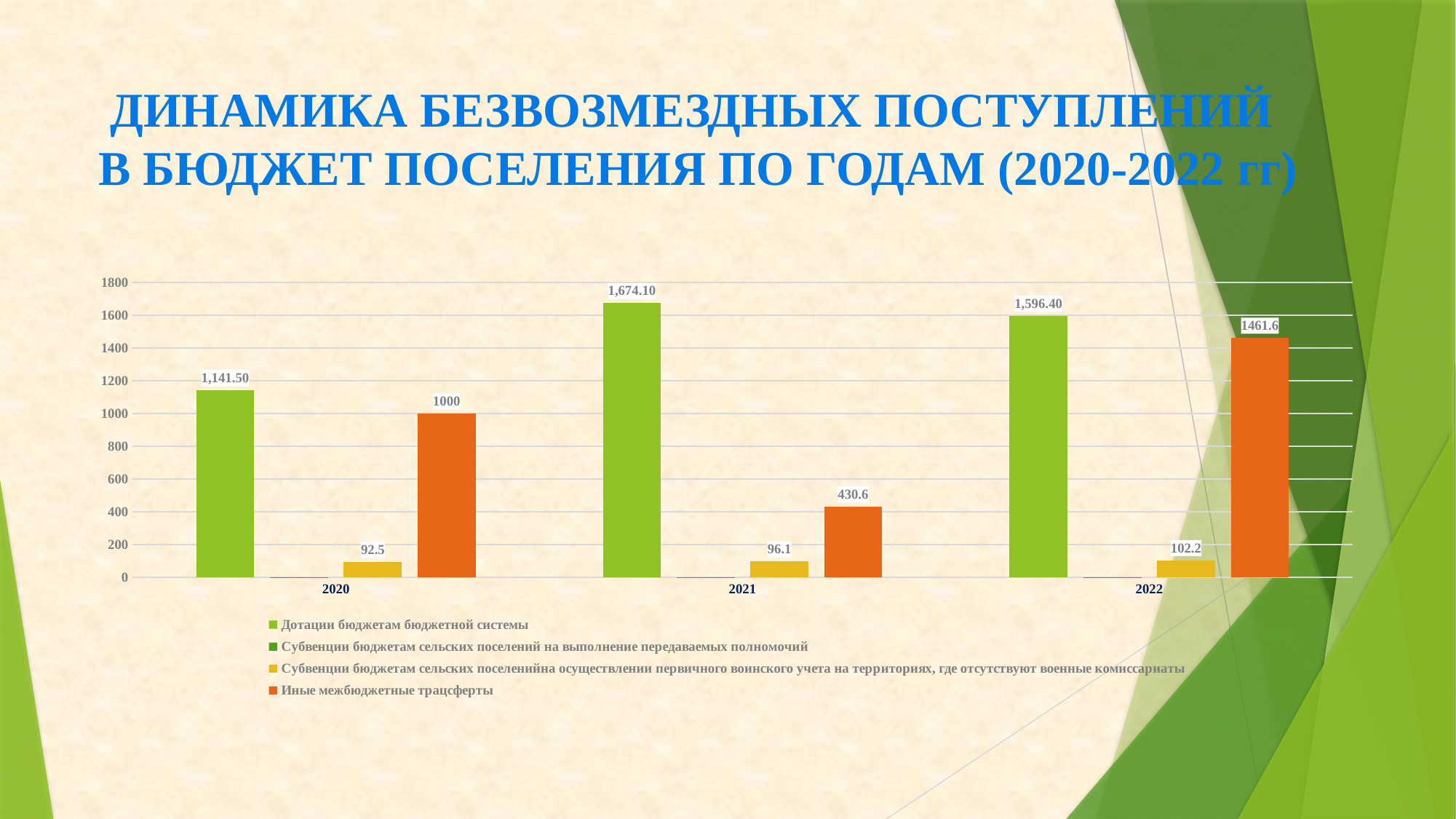
What type of chart is shown on the slide? bar chart Do the values for the yellow series (Субвенции на осуществление первичного воинского учета) rise or fall from 2020 to 2022? rise How many series does the legend list? 4 What is the difference between Иные межбюджетные трансферты in 2022 and in 2021? 1031 What is the value of Иные межбюджетные трансферты in 2021? 430.6 What is the value of Дотации бюджетам бюджетной системы in 2021? 1,674.10 What is the value of Дотации бюджетам бюджетной системы in 2020? 1,141.50 In which year is Иные межбюджетные трансферты lowest? 2021 How many years are shown on the x axis? 3 What is the value of Иные межбюджетные трансферты in 2022? 1461.6 Which is larger in 2022: Дотации бюджетам бюджетной системы or Иные межбюджетные трансферты? Дотации бюджетам бюджетной системы In which year is Дотации бюджетам бюджетной системы highest? 2021